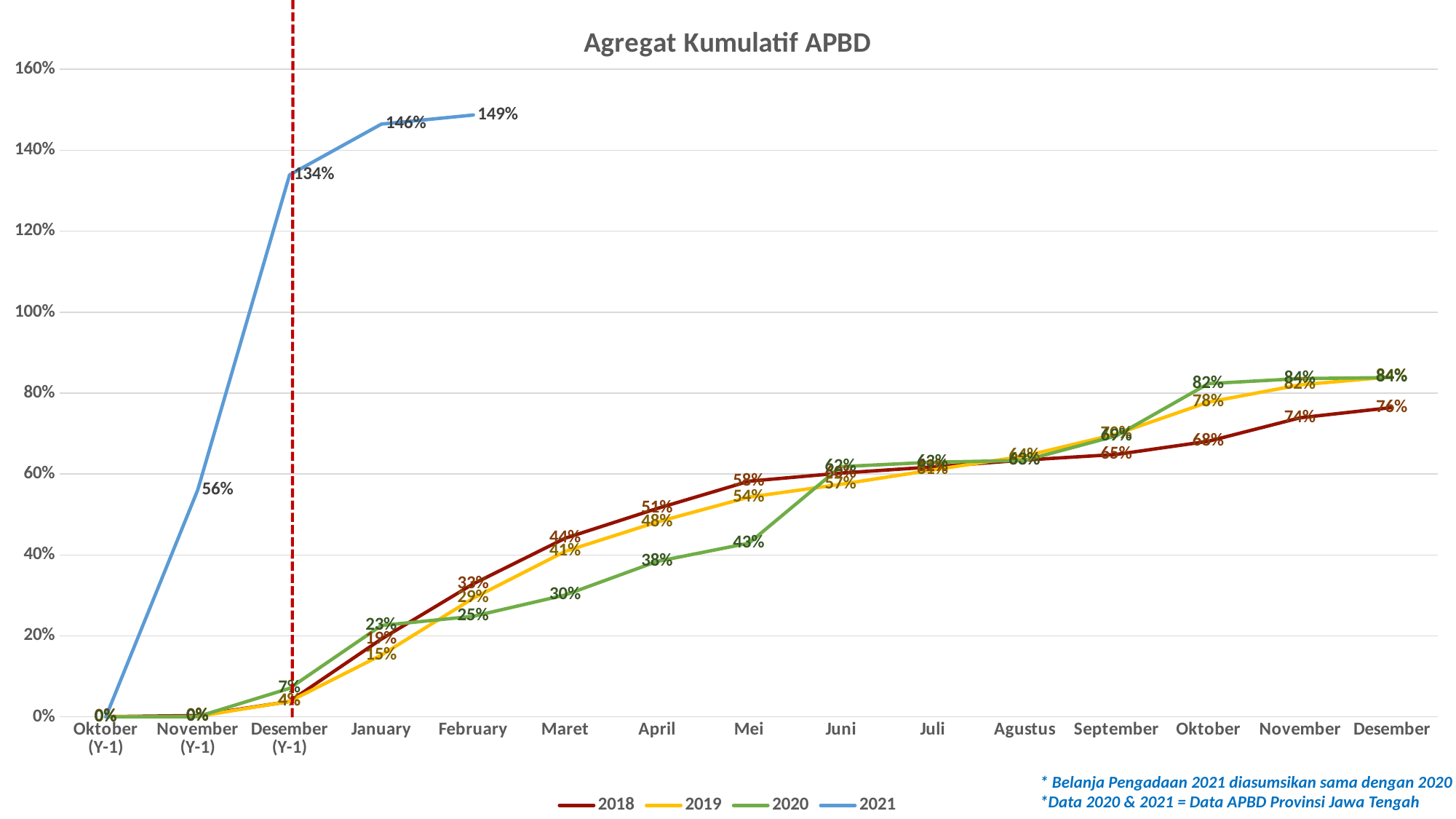
What is the value for 2021 in February? 149% What is the difference between the 2021 values in February (149%) and January (146%)? 3 percentage points Does the 2021 line rise or fall from Oktober (Y-1) to February? rise What is the value for 2020 in Mei? 43% How many series does the legend list? 4 What is the value for 2018 in Desember? 76% What is the value for 2019 in Oktober? 78% What kind of chart is shown on the slide? line chart Which series reaches the highest value on the chart? 2021 In April, which series has the larger value, 2018 or 2020? 2018 What is the value for 2021 in Desember (Y-1)? 134% How many categories are on the x axis? 15